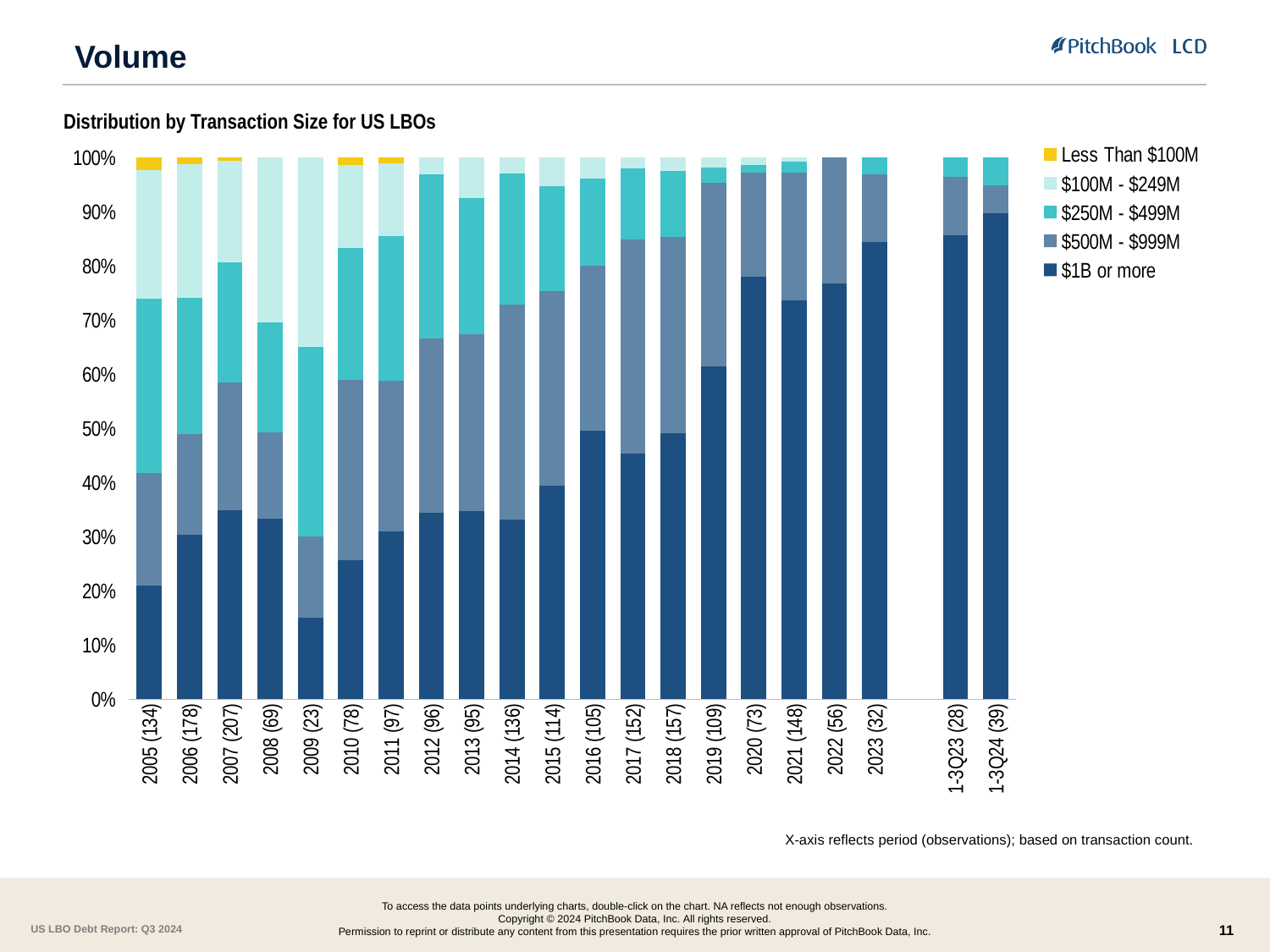
Which period has the fewest observations according to the x-axis labels? 2009 (23) How many observations are shown in the x-axis label for 2007? 207 What is the title of the chart? Distribution by Transaction Size for US LBOs Is the share of $1B or more deals in 2009 greater or less than 20%? less Which period has the most observations according to the x-axis labels? 2007 (207) Does the share of $1B or more deals generally rise or fall from 2005 to 2023? rise Which period has the smallest share of $1B or more deals? 2009 (23) What kind of chart is shown on the slide? Stacked bar chart How many periods (bars) are shown on the x axis? 21 Is the share of $1B or more deals in 1-3Q24 greater or less than 80%? greater Which legend entry represents the largest transaction size bucket? $1B or more How many series does the legend list? 5